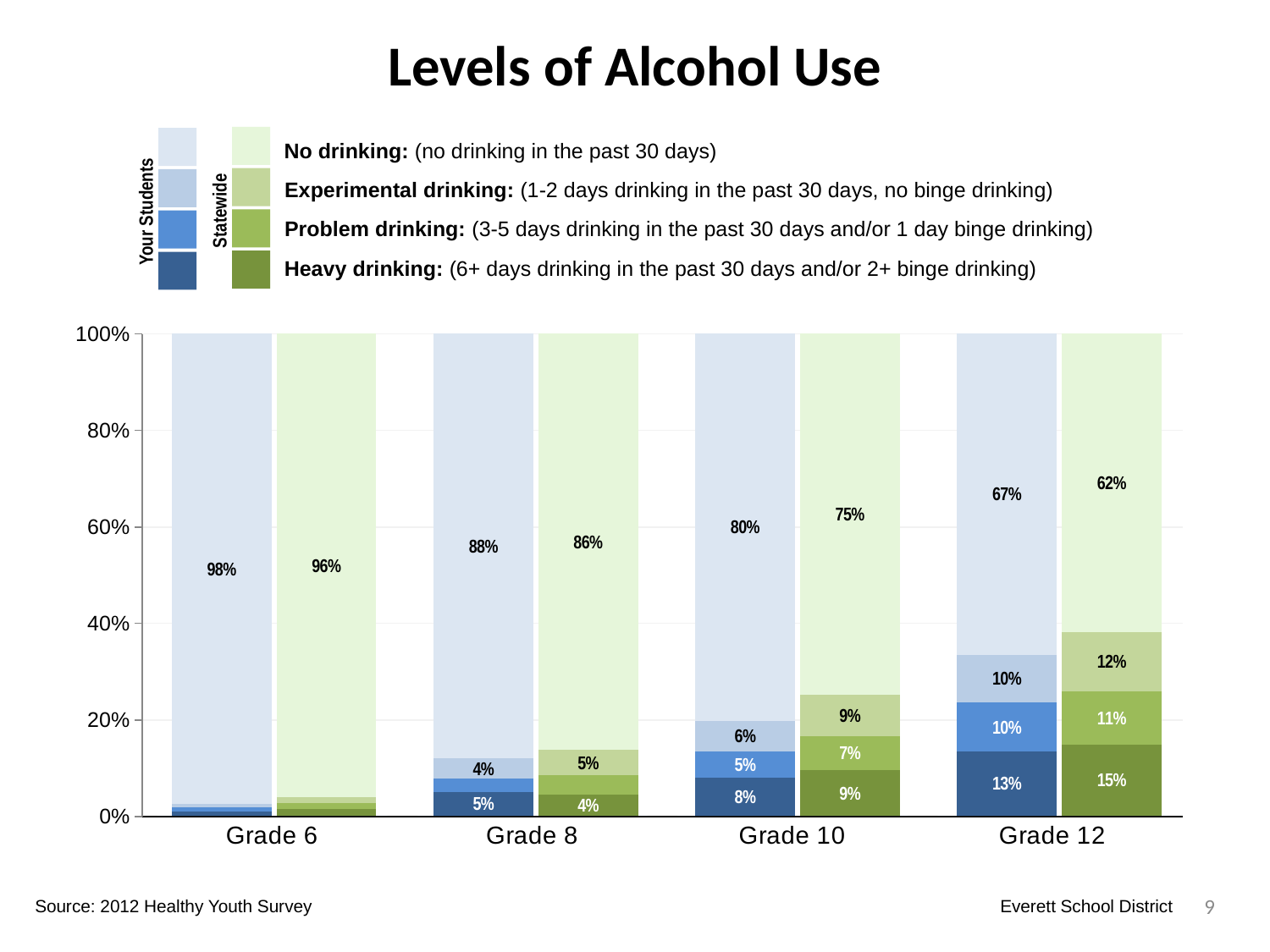
How many grade categories are shown on the x axis? 4 What is the difference between the Your Students and Statewide no-drinking percentages in Grade 10? 5% Which grade has the lowest no-drinking percentage for Your Students? Grade 12 What percentage of Your Students in Grade 12 reported heavy drinking? 13% In Grade 12, is the heavy drinking percentage higher for Your Students or Statewide? Statewide What percentage of Your Students in Grade 6 reported no drinking? 98% Which two groups are compared in the chart's legend? Your Students and Statewide What is the Statewide percentage for no drinking in Grade 10? 75% What kind of chart is shown on the slide? stacked bar chart How does the no-drinking percentage for Your Students change from Grade 6 to Grade 12? It falls What is the Statewide percentage for experimental drinking in Grade 12? 12% What percentage of Your Students in Grade 12 reported no drinking? 67%